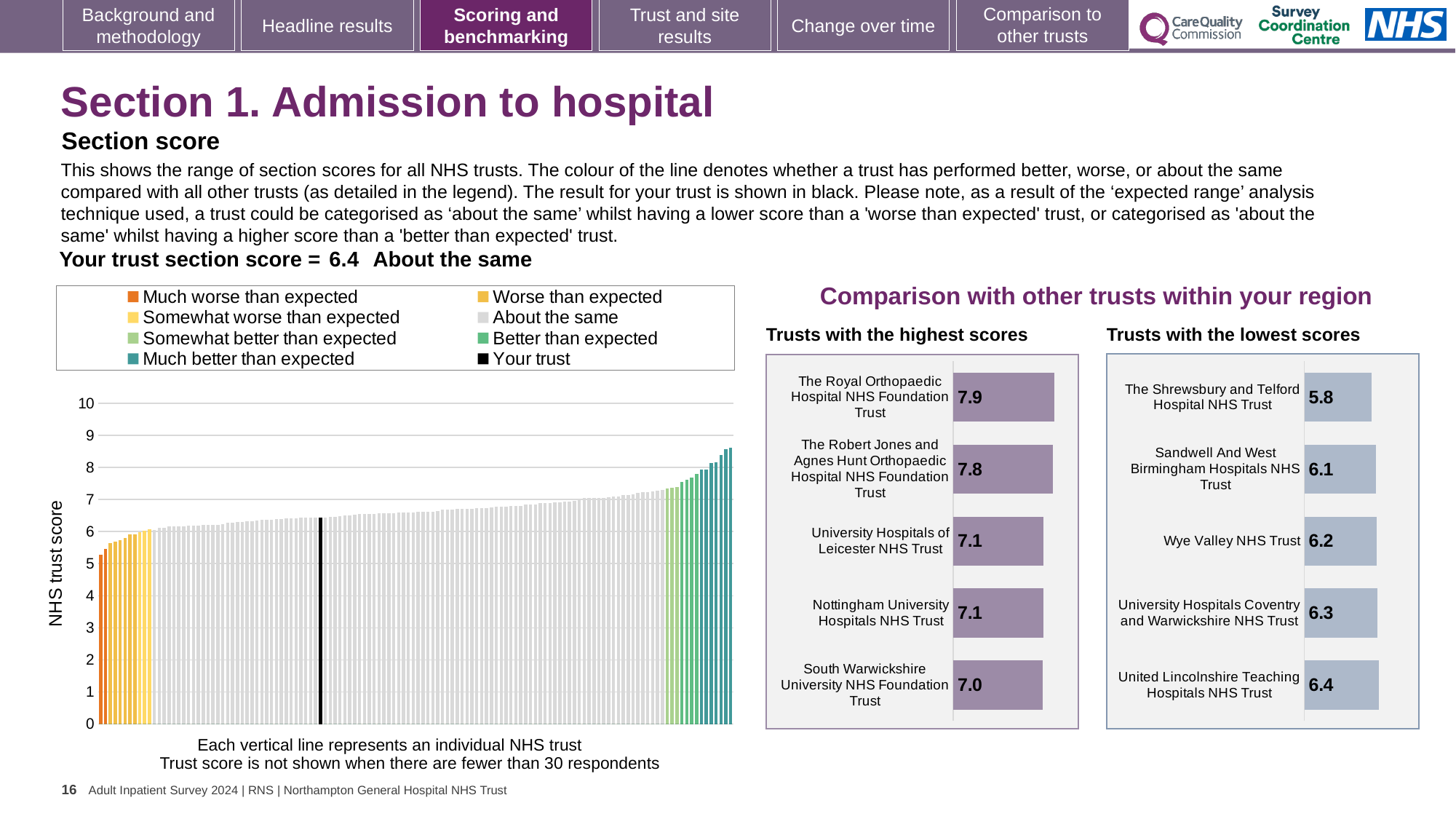
How many trusts are shown in the 'Trusts with the highest scores' chart? 5 In the 'Trusts with the highest scores' chart, what is the score for The Royal Orthopaedic Hospital NHS Foundation Trust? 7.9 In the 'Trusts with the highest scores' chart, what is the difference between the scores of The Royal Orthopaedic Hospital NHS Foundation Trust and South Warwickshire University NHS Foundation Trust? 0.9 How many entries does the legend of the large chart on the left list? 8 In the 'Trusts with the highest scores' chart, which trust has the highest score? The Royal Orthopaedic Hospital NHS Foundation Trust In the 'Trusts with the lowest scores' chart, which has the higher score: Sandwell And West Birmingham Hospitals NHS Trust or Wye Valley NHS Trust? Wye Valley NHS Trust In the 'Trusts with the lowest scores' chart, which trust has the lowest score? The Shrewsbury and Telford Hospital NHS Trust In the 'Trusts with the lowest scores' chart, what is the score for Wye Valley NHS Trust? 6.2 What kind of chart is the large chart on the left showing NHS trust scores? bar chart In the 'Trusts with the lowest scores' chart, what is the score for The Shrewsbury and Telford Hospital NHS Trust? 5.8 In the large chart on the left, what is the section score for your trust (the black bar)? 6.4 In the 'Trusts with the lowest scores' chart, what is the difference between the scores of United Lincolnshire Teaching Hospitals NHS Trust and The Shrewsbury and Telford Hospital NHS Trust? 0.6